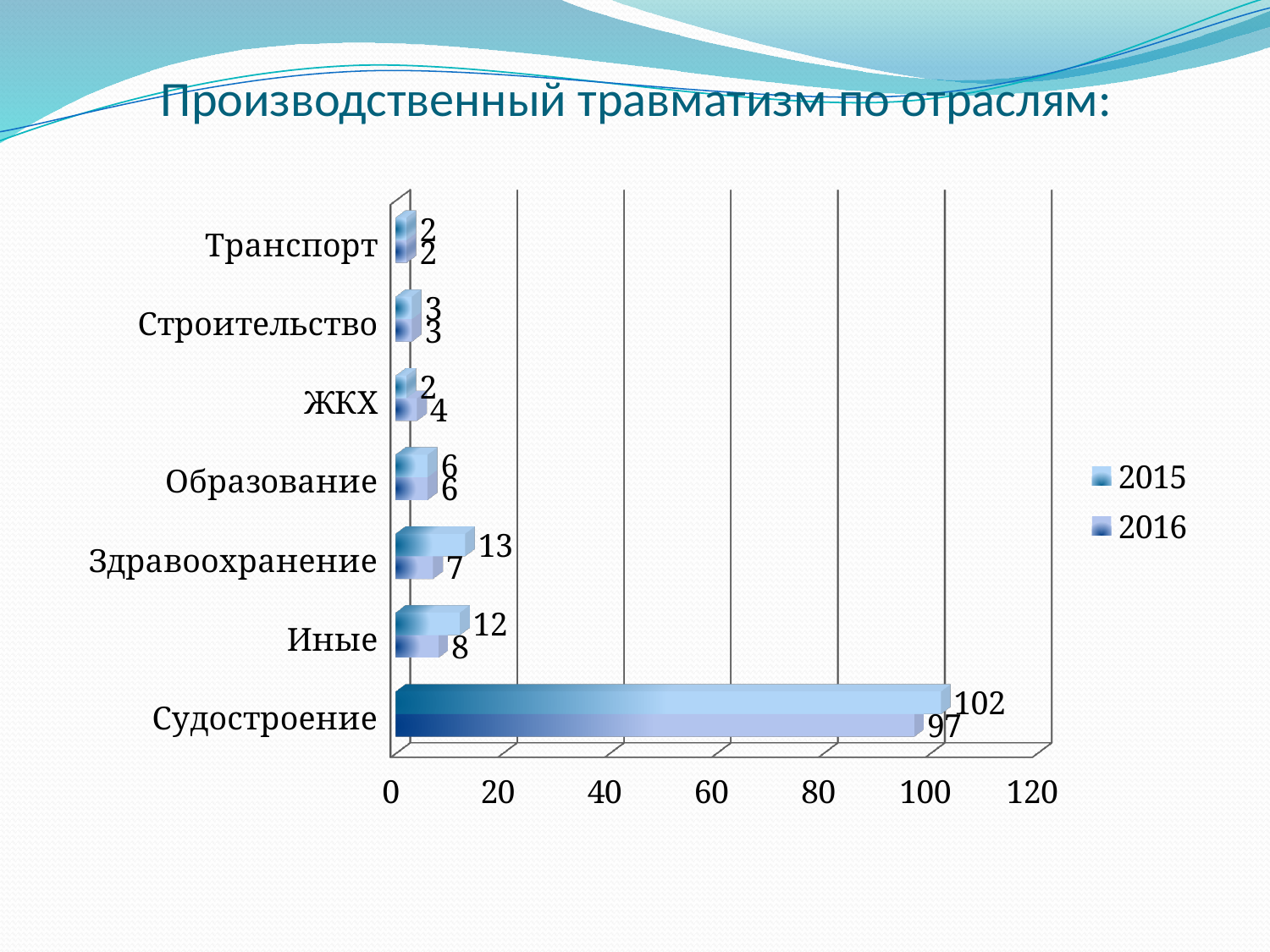
Which category has the lowest 2016 value? Транспорт Is the 2016 value for Судостроение greater or less than 80? greater Which category has the highest 2015 value? Судостроение How many categories are shown on the chart? 7 What is the 2015 value for Судостроение? 102 What is the 2016 value for ЖКХ? 4 What is the difference between the 2015 and 2016 values for Судостроение? 5 How many series does the legend list? 2 What kind of chart is shown on the slide? Bar chart What is the 2016 value for Судостроение? 97 What is the 2015 value for Здравоохранение? 13 Which is larger for Здравоохранение, the 2015 value or the 2016 value? 2015